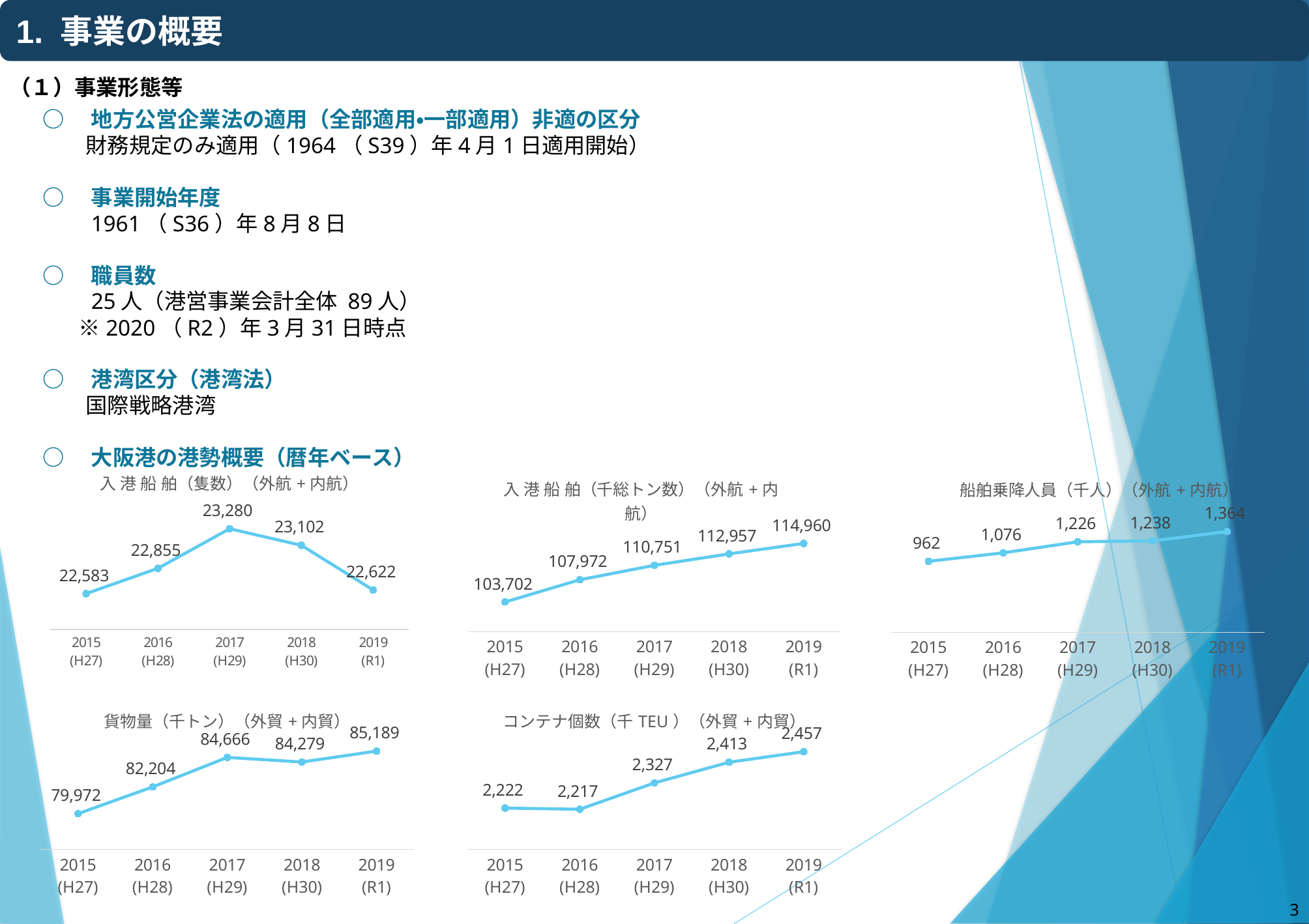
In the コンテナ個数（千TEU） chart, what is the difference between the 2019 and 2018 values? 44 In the コンテナ個数（千TEU） chart, what is the value for 2016 (H28)? 2,217 In the 船舶乗降人員（千人） chart, which year has the highest value? 2019 (R1) In the 入港船舶（隻数） chart, what is the value for 2017 (H29)? 23,280 In the 入港船舶（千総トン数） chart, what is the value for 2019 (R1)? 114,960 In the 入港船舶（隻数） chart, which year has the lowest value? 2015 (H27) In the 船舶乗降人員（千人） chart, what is the value for 2015 (H27)? 962 In the 入港船舶（千総トン数） chart, what is the difference between the 2019 and 2015 values? 11,258 In the 貨物量（千トン） chart, what is the value for 2018 (H30)? 84,279 In the 貨物量（千トン） chart, which is larger, the value for 2017 or the value for 2018? 2017 In the 入港船舶（千総トン数） chart, do the values rise or fall from 2015 to 2019? rise How many charts are shown on the slide, and what type are they? 5 line charts